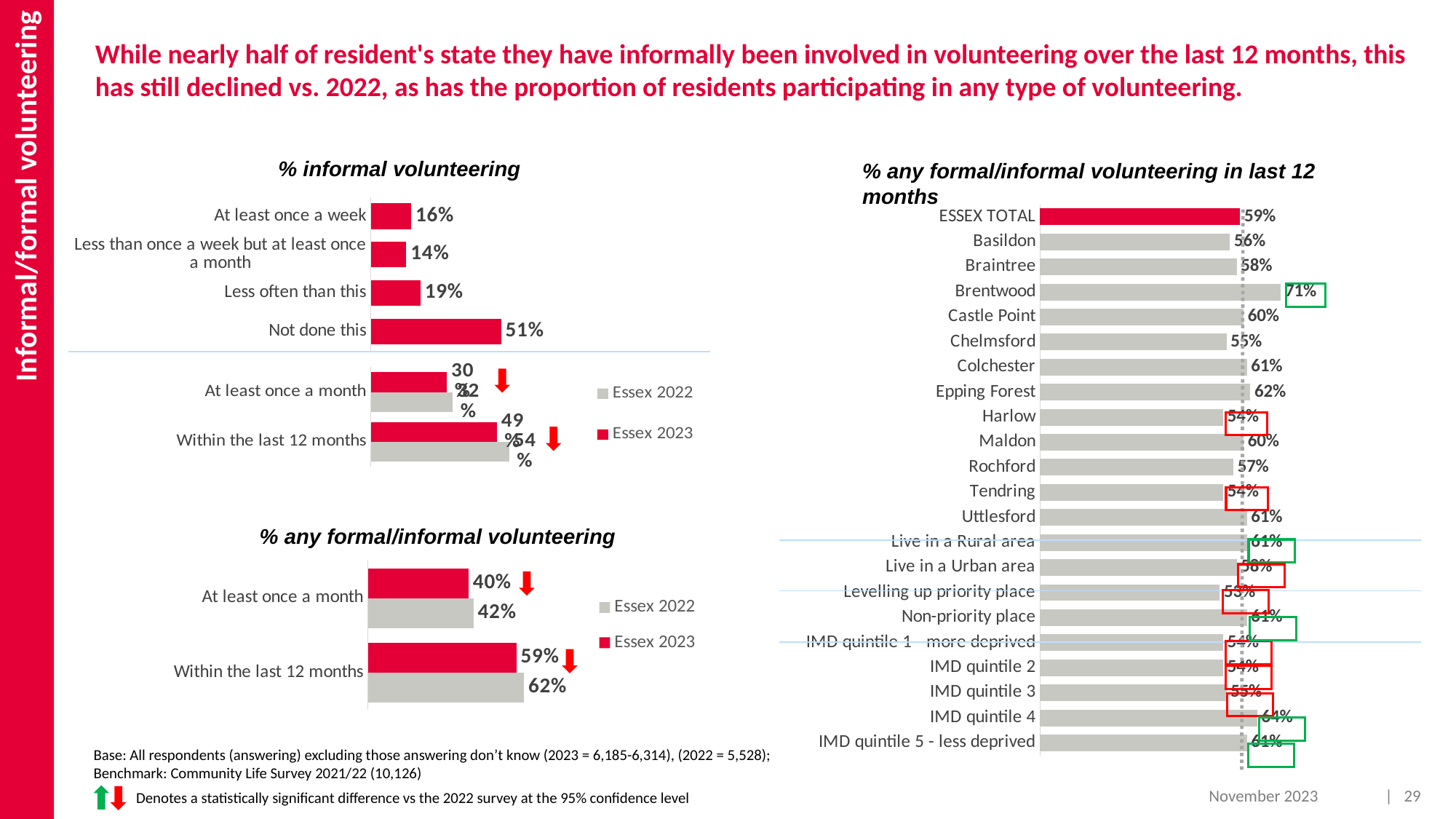
In the '% any formal/informal volunteering in last 12 months' chart, what is the value for Brentwood? 71% In the '% any formal/informal volunteering in last 12 months' chart, what is the value for ESSEX TOTAL? 59% In the '% informal volunteering' chart, what is the value for 'At least once a week'? 16% How many series does the legend of the '% any formal/informal volunteering' chart list? 2 In the '% informal volunteering' chart, which of the four frequency categories above the divider line has the highest value? Not done this In the '% informal volunteering' chart, which of the four frequency categories above the divider line has the lowest value? Less than once a week but at least once a month In the '% any formal/informal volunteering in last 12 months' chart, which is larger, Epping Forest or Chelmsford? Epping Forest In the '% any formal/informal volunteering' chart, what is the Essex 2023 value for 'At least once a month'? 40% In the '% any formal/informal volunteering' chart, what is the difference between the Essex 2022 and Essex 2023 values for 'Within the last 12 months'? 3 percentage points In the '% informal volunteering' chart, what is the value for 'Not done this'? 51% In the '% any formal/informal volunteering in last 12 months' chart, which category has the highest value? Brentwood What kind of chart is the '% any formal/informal volunteering in last 12 months' chart? Bar chart